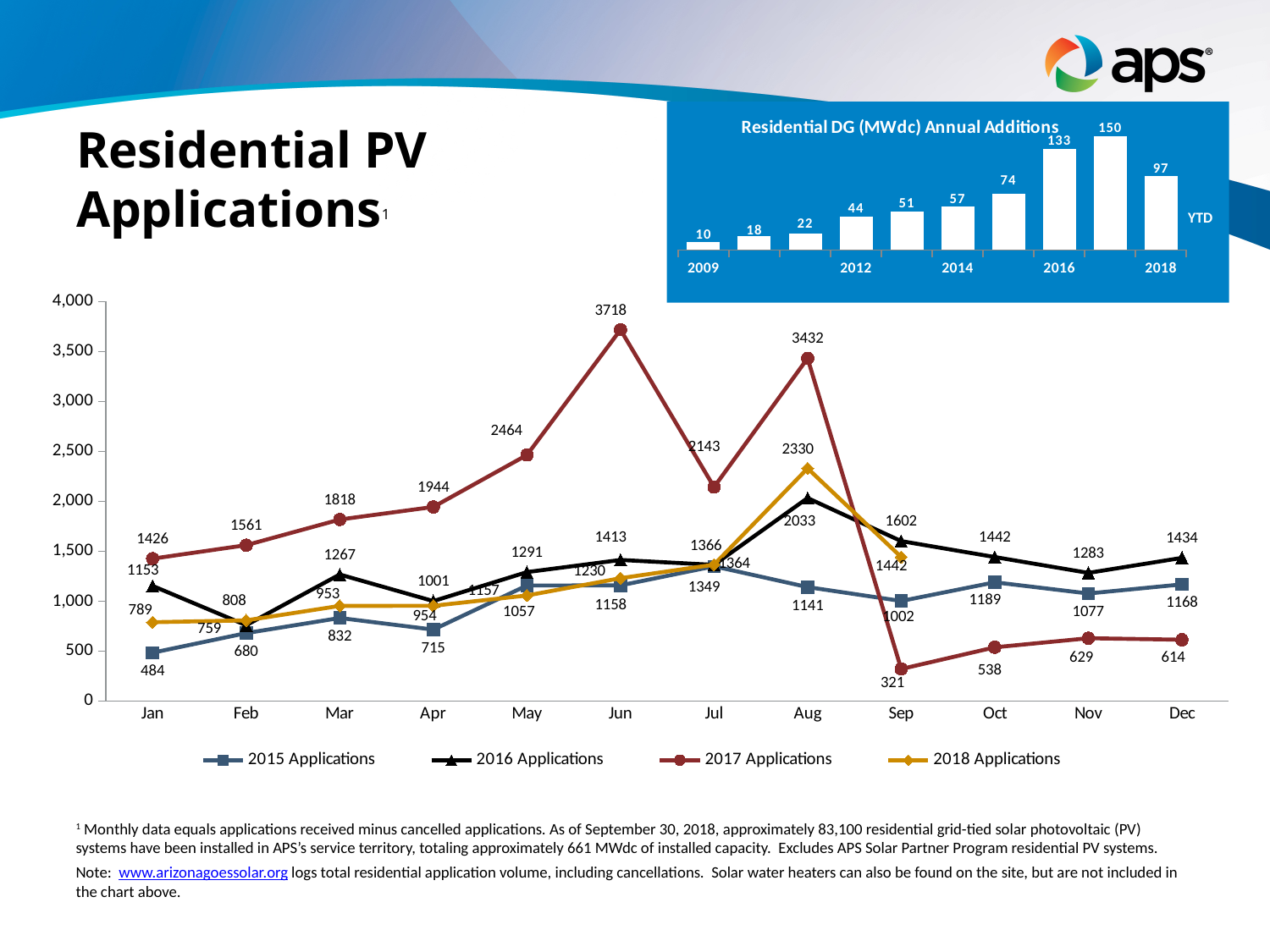
In the Residential PV Applications line chart, what is the value for 2015 Applications in January? 484 In the Residential PV Applications line chart, which month has the highest value for 2017 Applications? Jun In the Residential DG (MWdc) Annual Additions chart, what is the value for 2016? 133 What kind of chart is the Residential DG (MWdc) Annual Additions chart? Bar chart In the Residential PV Applications line chart, how many series does the legend list? 4 In the Residential DG (MWdc) Annual Additions chart, what is the value for 2009? 10 In the Residential PV Applications line chart, how many months are shown on the x axis? 12 In the Residential PV Applications line chart, what is the value for 2018 Applications in August? 2330 In the Residential PV Applications line chart, what is the difference between 2017 Applications and 2016 Applications in August? 1399 In the Residential PV Applications line chart, which is larger in September: 2016 Applications or 2018 Applications? 2016 Applications In the Residential PV Applications line chart, which month has the lowest value for 2017 Applications? Sep In the Residential PV Applications line chart, what is the value for 2017 Applications in June? 3718